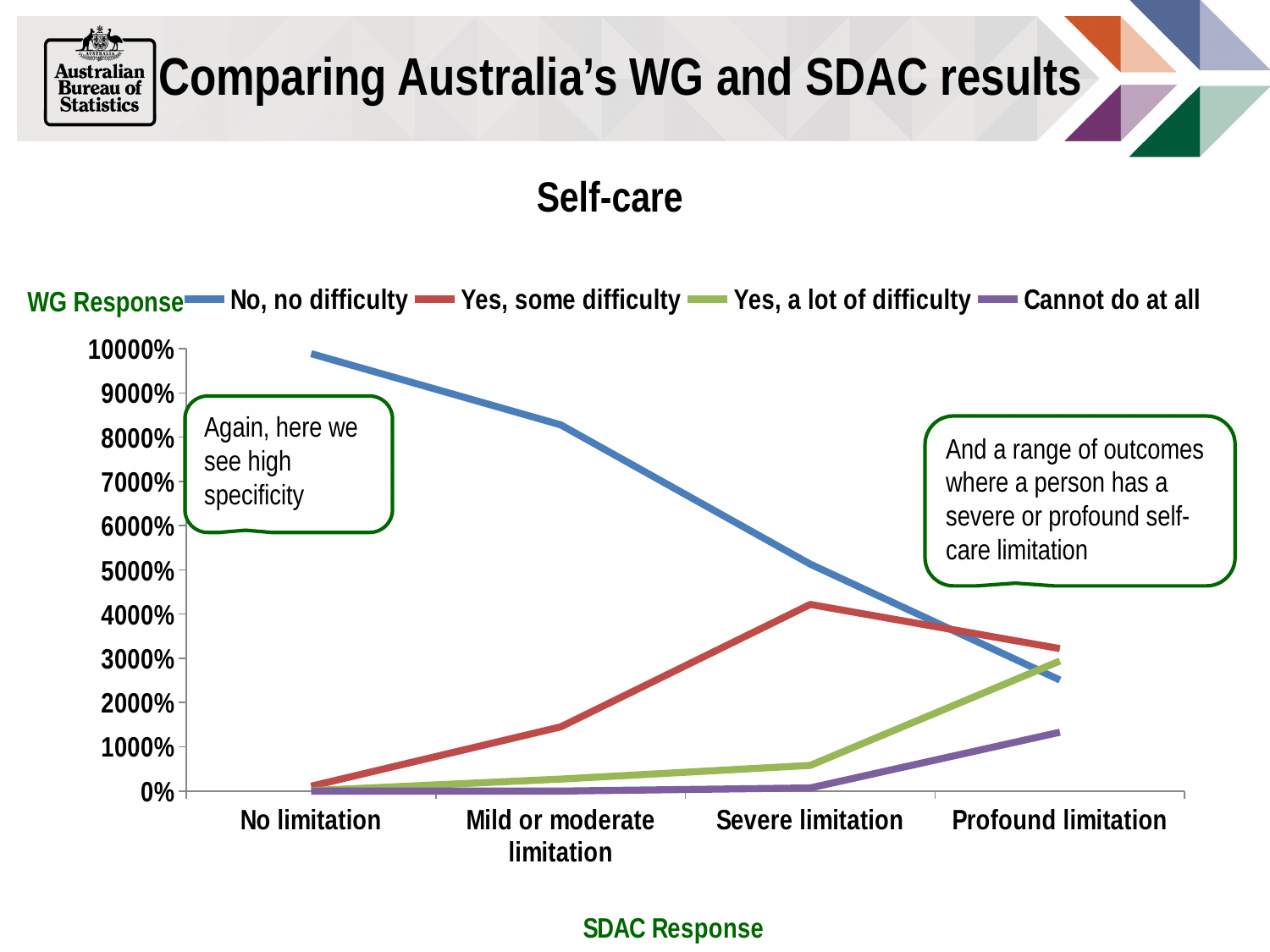
Is the value for 'No, no difficulty' at 'No limitation' greater or less than 9000%? greater How many SDAC Response categories are shown on the x axis? 4 Is the value for 'Cannot do at all' at 'Profound limitation' greater or less than 1000%? greater Is the value for 'Yes, some difficulty' at 'Severe limitation' greater or less than 3000%? greater Which series has the lowest value at 'Profound limitation'? Cannot do at all At 'Mild or moderate limitation', which is larger: 'No, no difficulty' or 'Yes, some difficulty'? No, no difficulty How many series does the legend list? 4 Does the 'No, no difficulty' line rise or fall from 'No limitation' to 'Profound limitation'? fall Which SDAC Response category has the highest value for 'No, no difficulty'? No limitation What kind of chart is shown on the slide? line chart Does the 'Cannot do at all' line rise or fall from 'No limitation' to 'Profound limitation'? rise